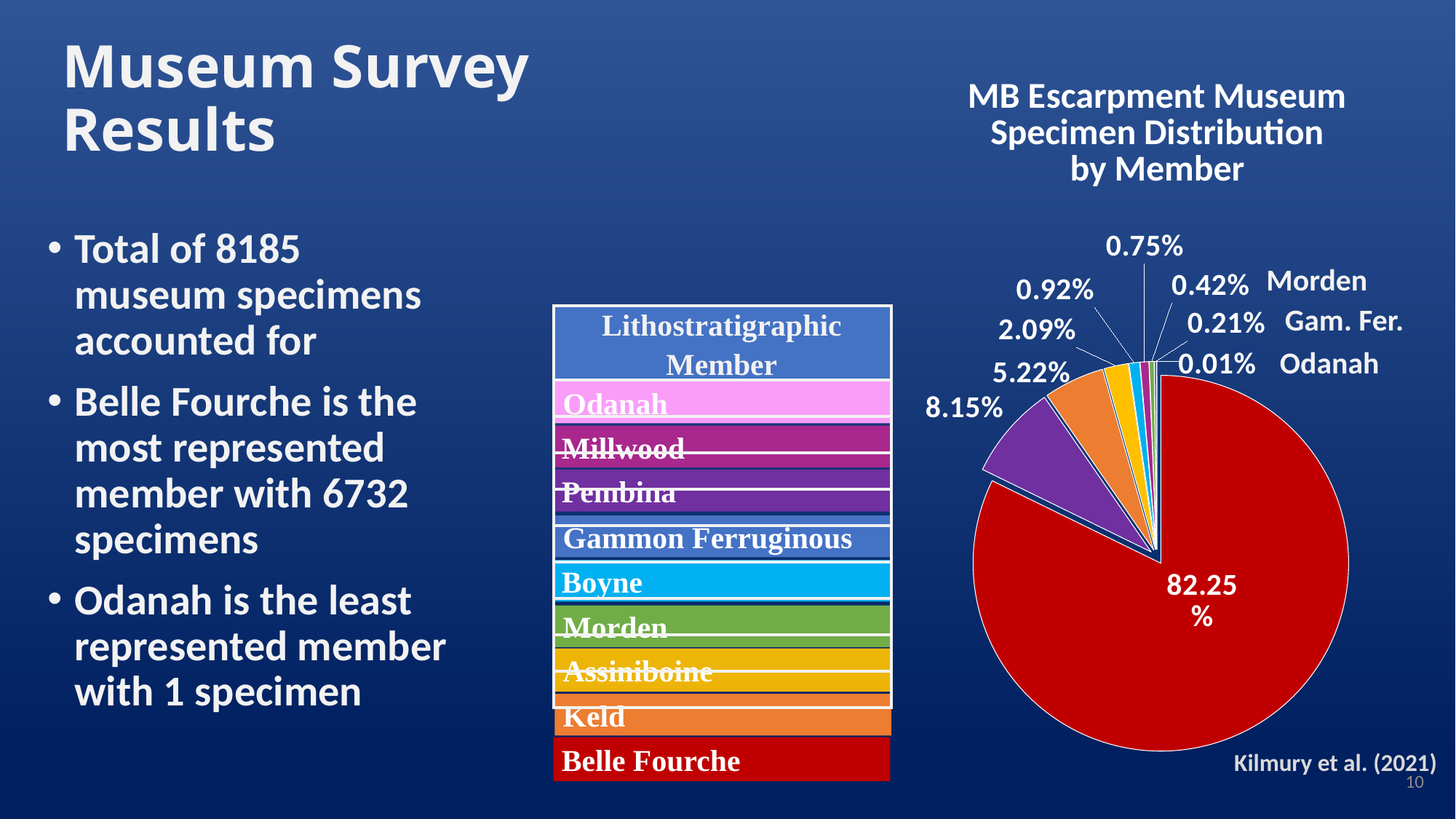
In the pie chart, what percentage is shown for the second-largest slice? 8.15% In the pie chart, what share is labelled for Morden? 0.42% What kind of chart is shown on the right of the slide? pie chart In the pie chart, what share is labelled for Odanah? 0.01% In the pie chart, what share is labelled for Gam. Fer.? 0.21% In the pie chart, which labelled member has the smallest share? Odanah How many slices are labelled with percentages in the pie chart? 9 In the pie chart, what percentage is shown for the largest slice? 82.25% In the pie chart, what is the difference between the largest slice (82.25%) and the second-largest slice (8.15%)? 74.10% What is the title of the pie chart? MB Escarpment Museum Specimen Distribution by Member In the pie chart, what is the difference between the Morden share and the Gam. Fer. share? 0.21% In the pie chart, which has the larger share, Morden or Odanah? Morden